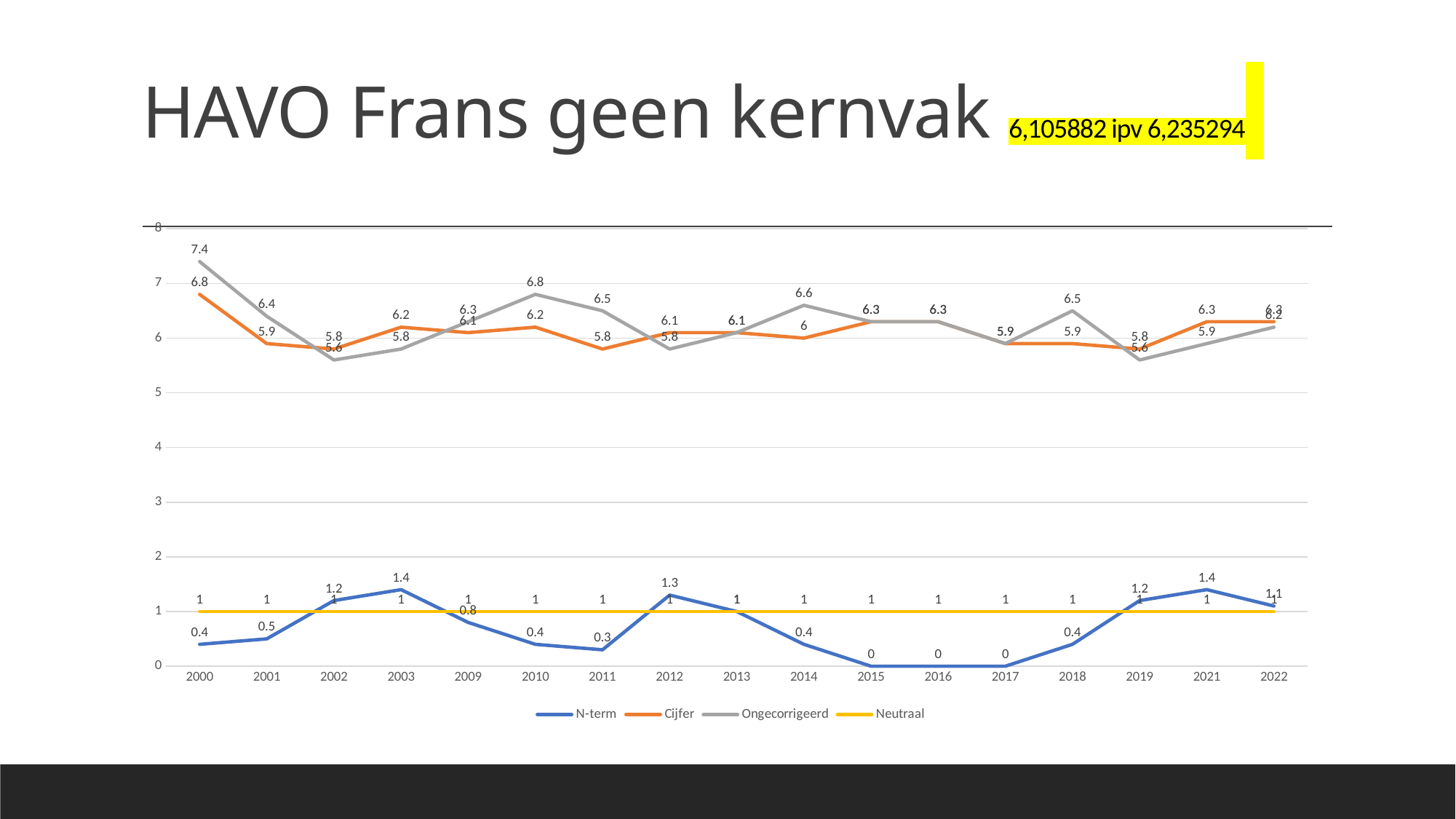
What is the Cijfer value for 2000? 6.8 Which is larger in 2010, the Cijfer value or the Ongecorrigeerd value? Ongecorrigeerd Is the Cijfer value for 2013 greater or less than 5? greater What type of chart is shown on the slide? line chart What is the difference between the Cijfer values for 2000 and 2001? 0.9 What is the N-term value for 2016? 0 What is the Ongecorrigeerd value for 2000? 7.4 How many years are plotted along the x axis? 17 What is the title of the slide? HAVO Frans geen kernvak In which year is the Ongecorrigeerd series highest? 2000 What is the N-term value for 2003? 1.4 How many series does the legend list? 4